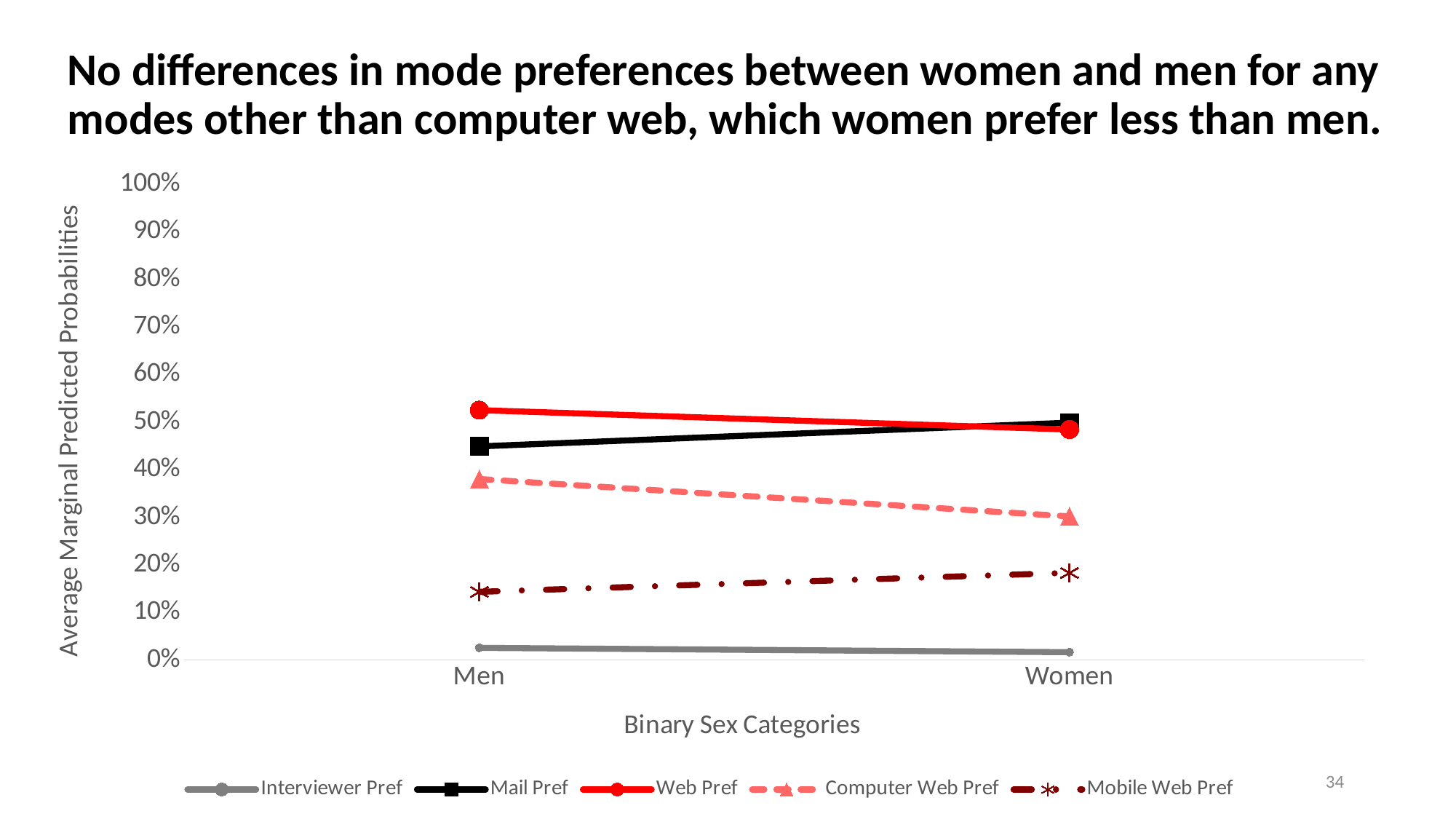
For Men, which is larger: Web Pref or Mail Pref? Web Pref Is the value for Web Pref for Men greater or less than 40%? greater What is the title of the y axis? Average Marginal Predicted Probabilities Does the Computer Web Pref line rise or fall from Men to Women? fall How many categories are shown on the x axis? 2 Which series has the lowest value for Women? Interviewer Pref Is the value for Computer Web Pref for Women greater or less than 40%? less Does the Mobile Web Pref line rise or fall from Men to Women? rise Which series has the highest value for Men? Web Pref What kind of chart is shown on the slide? line chart How many series does the legend list? 5 Is the value for Mobile Web Pref for Men greater or less than 20%? less